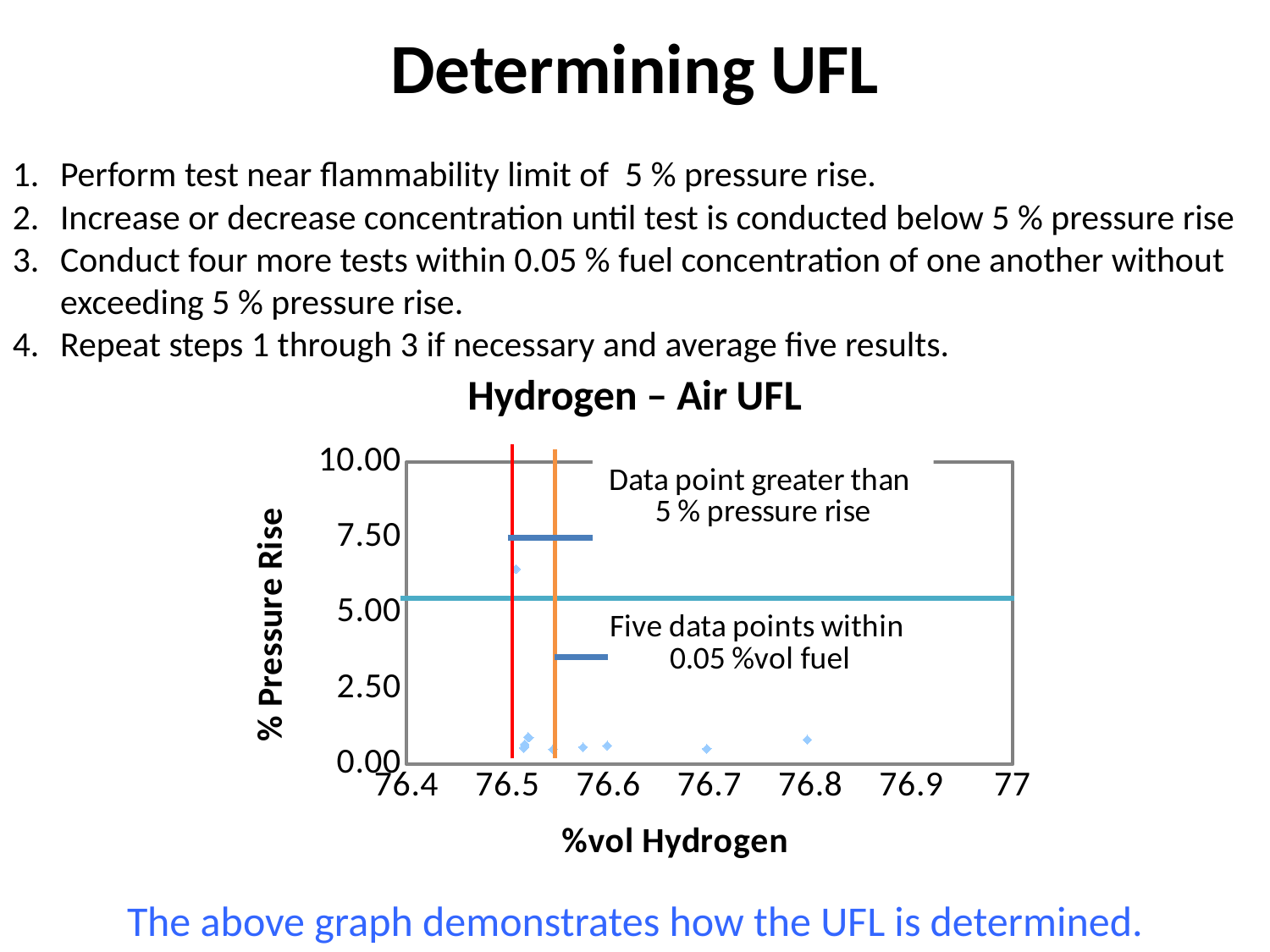
What is the highest value shown on the x axis of the chart? 77 Which has the higher pressure rise: the leftmost data point or the data point near 76.8 %vol hydrogen? the leftmost data point What is the highest value shown on the y axis of the chart? 10.00 Is the highest data point on the chart greater or less than 7.50 % pressure rise? less What is the title of the chart? Hydrogen – Air UFL Is the highest data point on the chart greater or less than 5.00 % pressure rise? greater What is the lowest value shown on the x axis of the chart? 76.4 What kind of chart is shown on the slide? scatter chart What is the title of the x axis of the chart? %vol Hydrogen Is the data point near 76.7 %vol hydrogen greater or less than 2.50 % pressure rise? less How many data points on the chart lie above 5.00 % pressure rise? 1